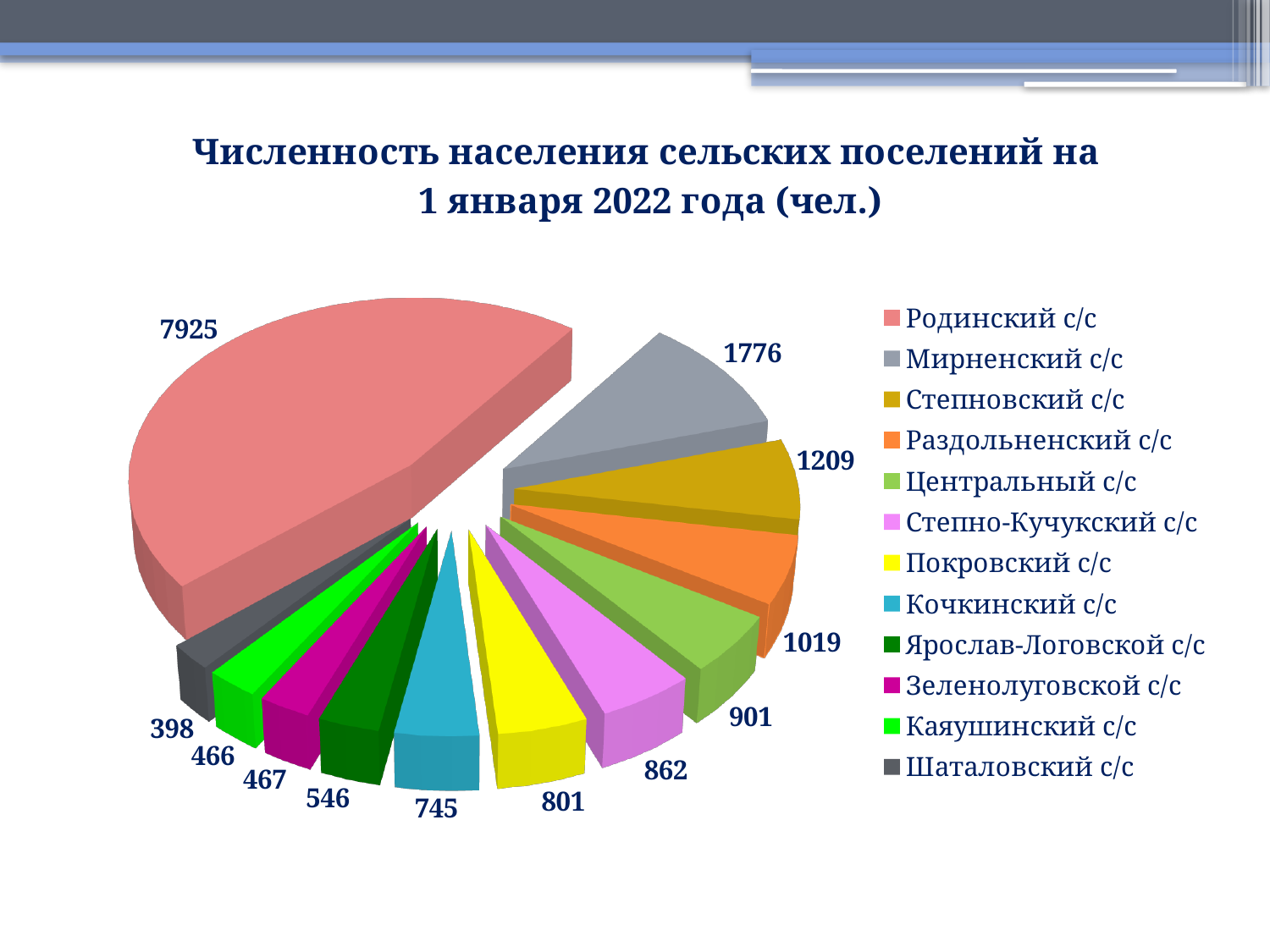
Which has a larger population, Центральный с/с or Покровский с/с? Центральный с/с What is the difference between the populations of Мирненский с/с and Степновский с/с? 567 Which settlement has the smallest population? Шаталовский с/с What is the population of Шаталовский с/с? 398 What is the population of Кочкинский с/с? 745 What is the population of Родинский с/с? 7925 What is the population of Мирненский с/с? 1776 What is the title of the chart? Численность населения сельских поселений на 1 января 2022 года (чел.) Which settlement has the largest population? Родинский с/с How many settlements are shown in the pie chart? 12 What type of chart is shown on the slide? pie chart What is the total population across all settlements shown? 17115